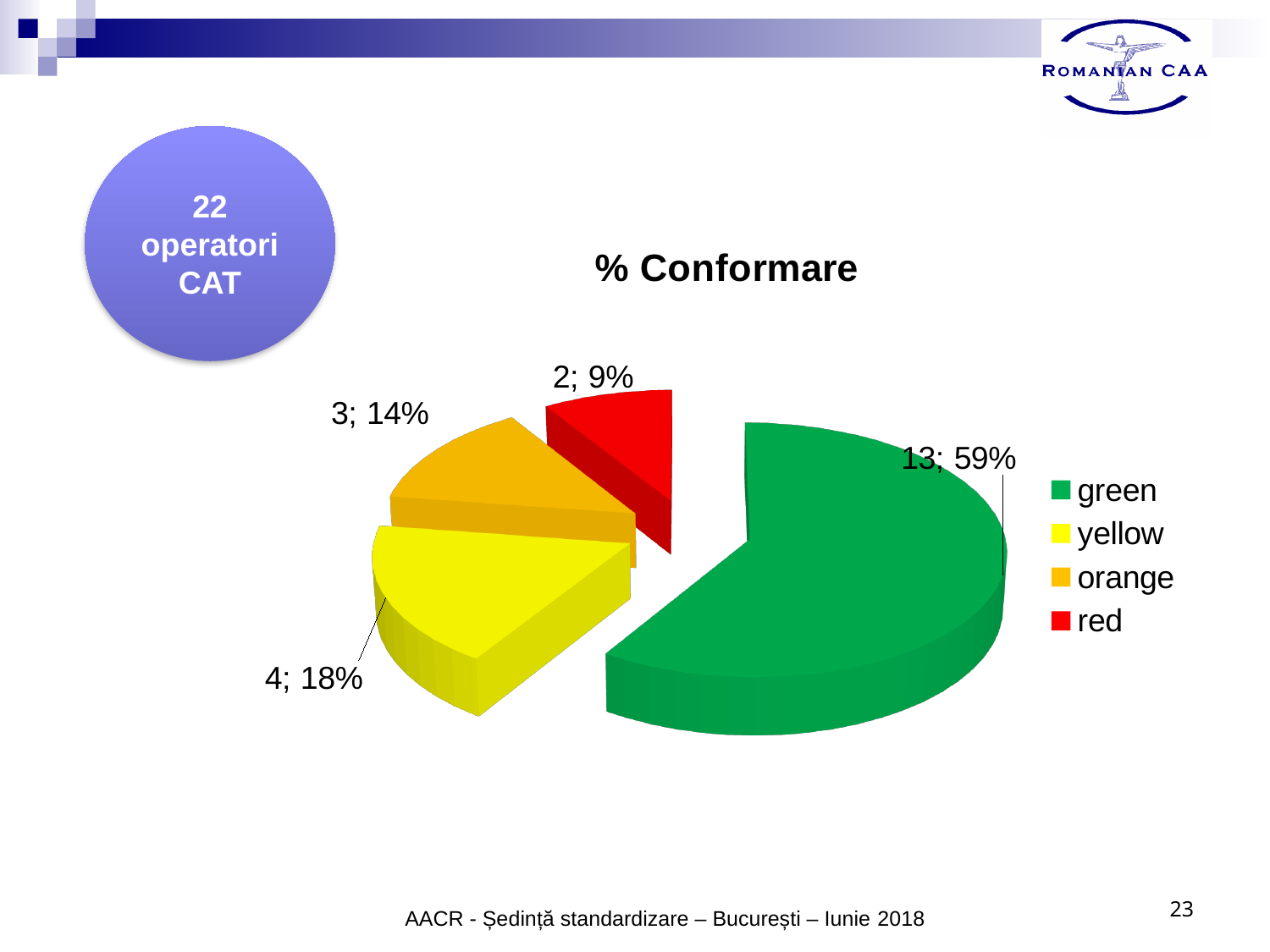
What percentage share does the orange slice have? 14% What percentage share does the green slice have? 59% What is the count for the green slice? 13 What is the difference between the green count and the yellow count? 9 What kind of chart is shown on the slide? pie chart Which category has the largest slice? green What is the title of the chart? % Conformare How many slices does the pie chart have? 4 How many entries does the legend list? 4 What is the count for the yellow slice? 4 What is the count for the red slice? 2 Which category has the smallest slice? red